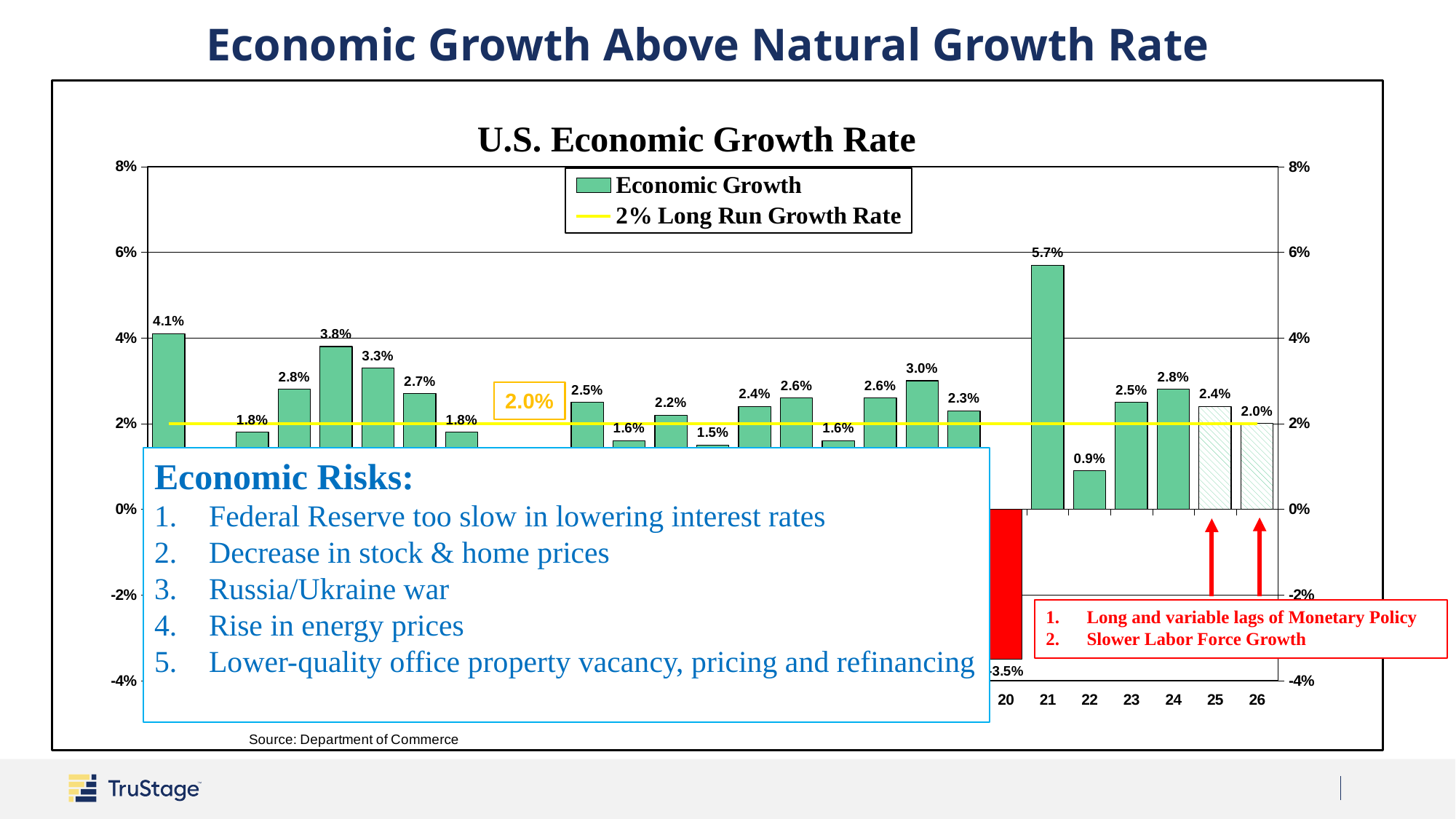
What is the difference between the economic growth rate for 21 and for 22? 4.8% What is the economic growth rate for 21? 5.7% Which is larger, the economic growth rate for 23 or for 25? 23 What is the economic growth rate for 24? 2.8% What is the title of the chart? U.S. Economic Growth Rate Which year has the highest economic growth rate? 21 What is the economic growth rate for 26? 2.0% What type of chart is used to show Economic Growth? bar chart What is the economic growth rate for 22? 0.9% How many series does the legend list? 2 What is the value of the long run growth rate line shown in the legend? 2% Which year has the lowest economic growth rate? 20